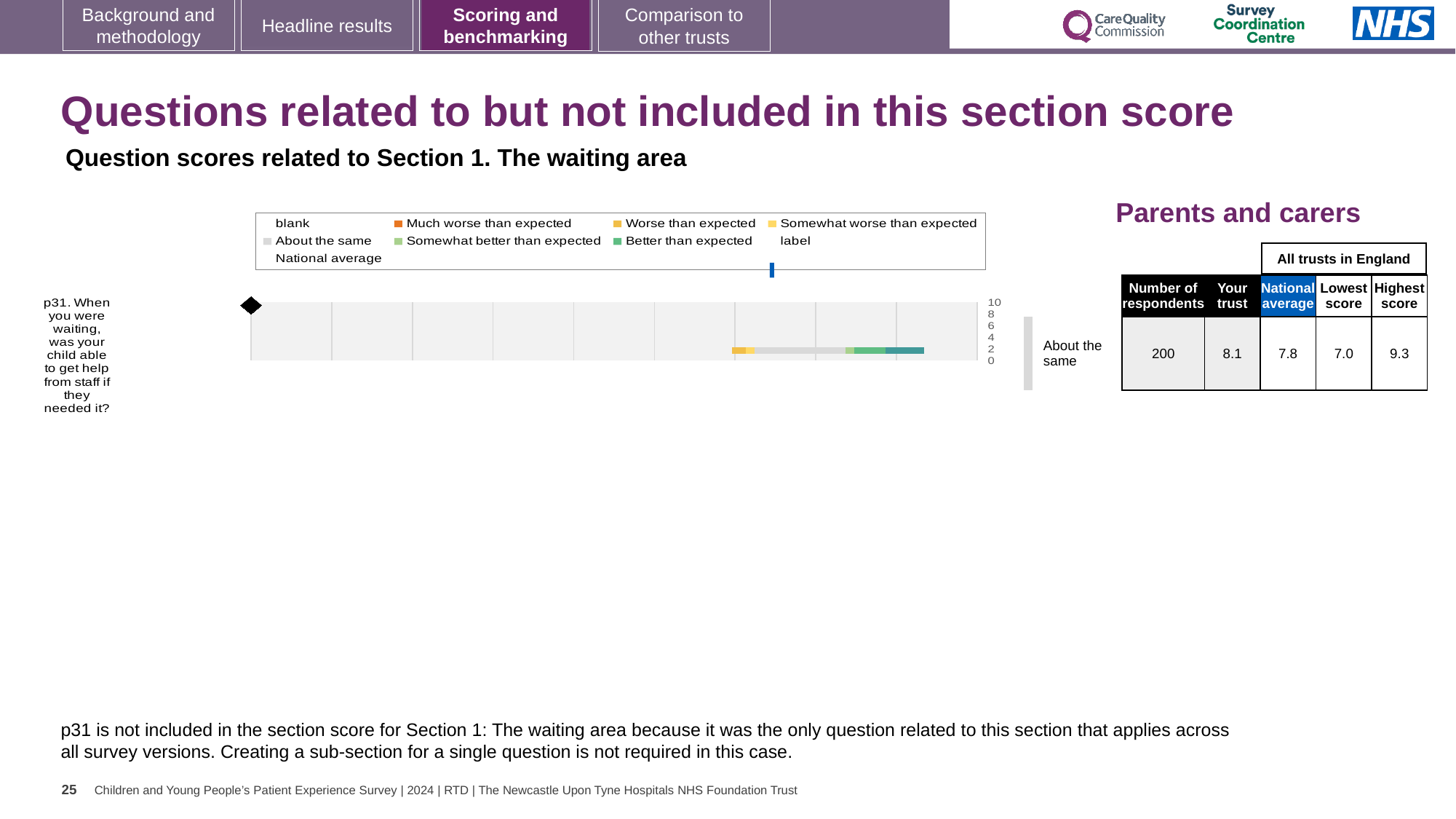
What benchmark category is shown to the right of the bar for p31? About the same In the table beside the chart, what is the difference between the highest score and the lowest score for p31? 2.3 In the table beside the chart, how many respondents answered p31? 200 How many questions are plotted in the chart? 1 In the table beside the chart, what is the lowest score among all trusts in England for p31? 7.0 How many entries does the chart legend list? 9 What colour represents 'Much worse than expected' in the chart legend? orange What kind of chart is used to show the p31 question score? bar chart What is the highest tick value shown on the chart's axis? 10 In the table beside the chart, what is the national average score for p31? 7.8 In the table beside the chart, which is larger for p31: the 'Your trust' score or the national average? Your trust In the table beside the chart, what is the 'Your trust' score for p31? 8.1